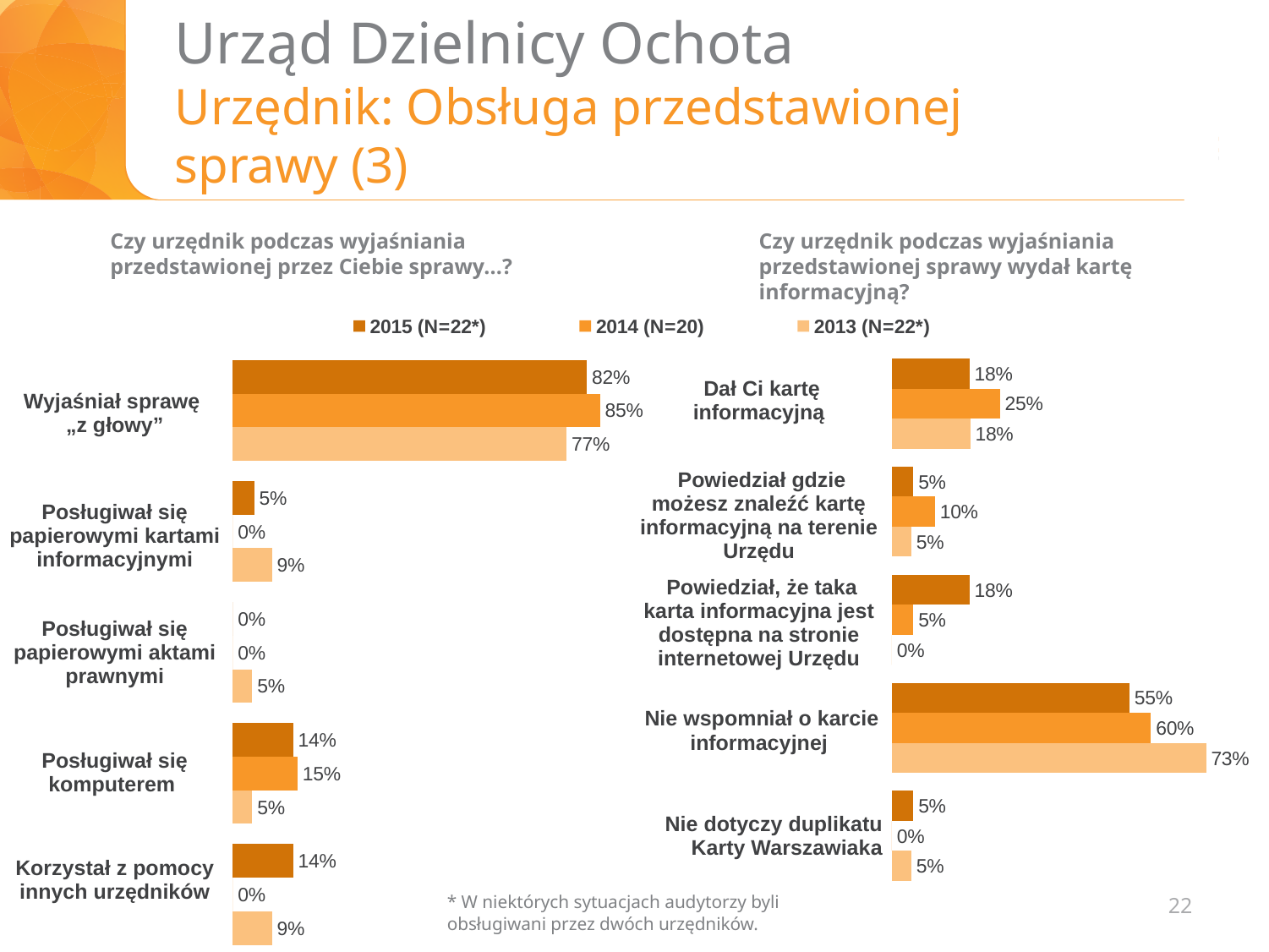
In the left chart, how many categories are shown? 5 In the right chart ("Czy urzędnik podczas wyjaśniania przedstawionej sprawy wydał kartę informacyjną?"), what is the 2013 value for "Nie wspomniał o karcie informacyjnej"? 73% In the right chart, what is the difference between the 2014 and 2015 values for "Nie wspomniał o karcie informacyjnej"? 5% What type of chart is used on this slide? Bar chart In the left chart, which category has the highest 2014 value? Wyjaśniał sprawę „z głowy” In the left chart, what is the 2013 value for "Posługiwał się komputerem"? 5% How many series does the legend list? 3 In the left chart, what is the difference between the 2014 and 2013 values for "Wyjaśniał sprawę „z głowy”"? 8% In the left chart ("Czy urzędnik podczas wyjaśniania przedstawionej przez Ciebie sprawy...?"), what is the 2015 value for "Wyjaśniał sprawę „z głowy”"? 82% In the right chart, which category has the lowest 2013 value? Powiedział, że taka karta informacyjna jest dostępna na stronie internetowej Urzędu In the right chart, what is the 2014 value for "Dał Ci kartę informacyjną"? 25% In the right chart, which is larger for "Powiedział, że taka karta informacyjna jest dostępna na stronie internetowej Urzędu": the 2015 value or the 2014 value? 2015